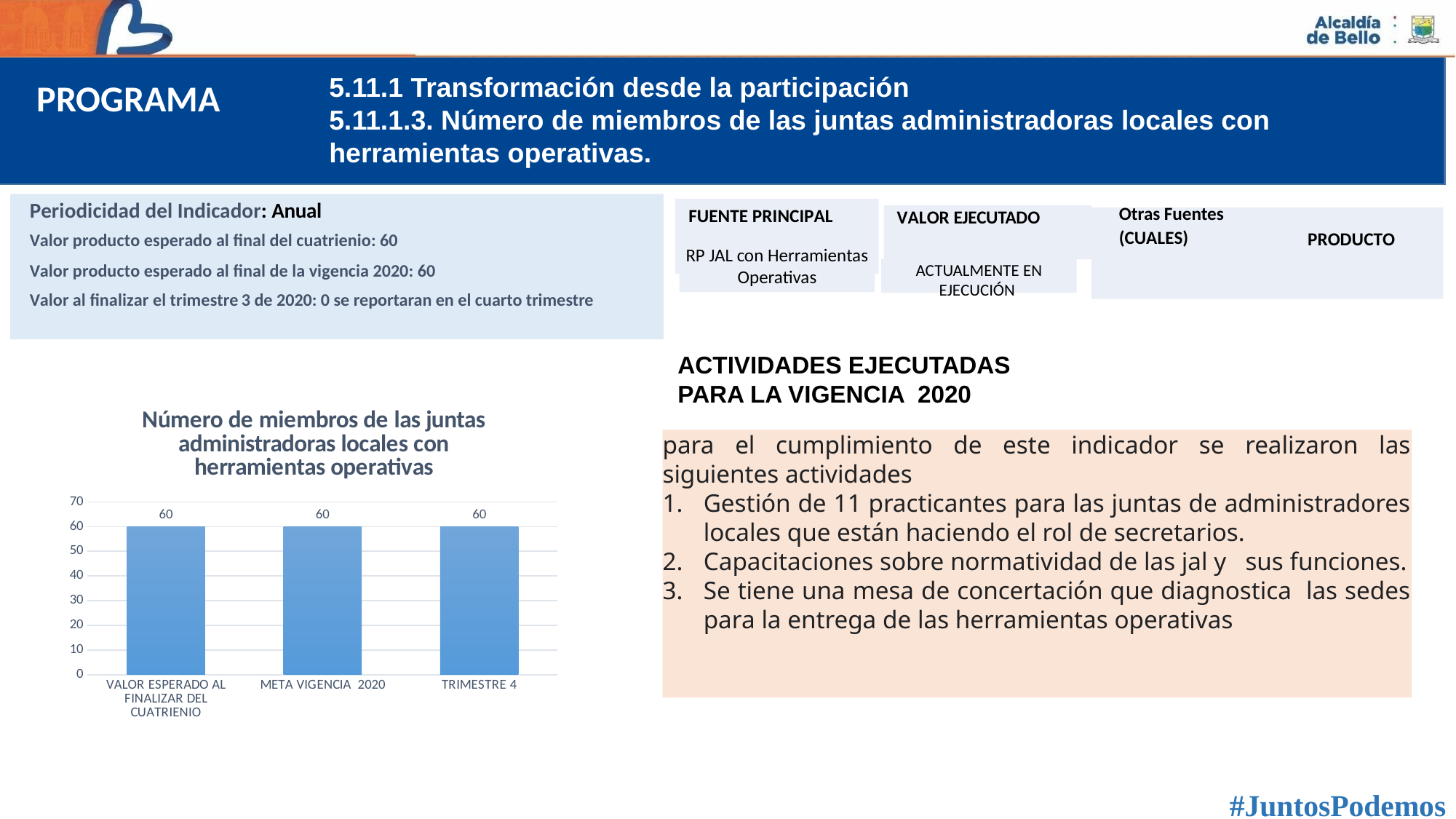
Is the value for TRIMESTRE 4 greater or less than 50? greater What is the value for VALOR ESPERADO AL FINALIZAR DEL CUATRIENIO? 60 What is the value for TRIMESTRE 4? 60 What kind of chart is shown on the slide? bar chart Is the value for VALOR ESPERADO AL FINALIZAR DEL CUATRIENIO greater or less than 70? less What is the value for META VIGENCIA 2020? 60 Do the values rise, fall, or stay the same across the categories from left to right? stay the same What is the highest value shown on the vertical axis of the chart? 70 What is the difference between the value for META VIGENCIA 2020 and the value for TRIMESTRE 4? 0 What is the title of the chart? Número de miembros de las juntas administradoras locales con herramientas operativas How many categories are shown on the chart? 3